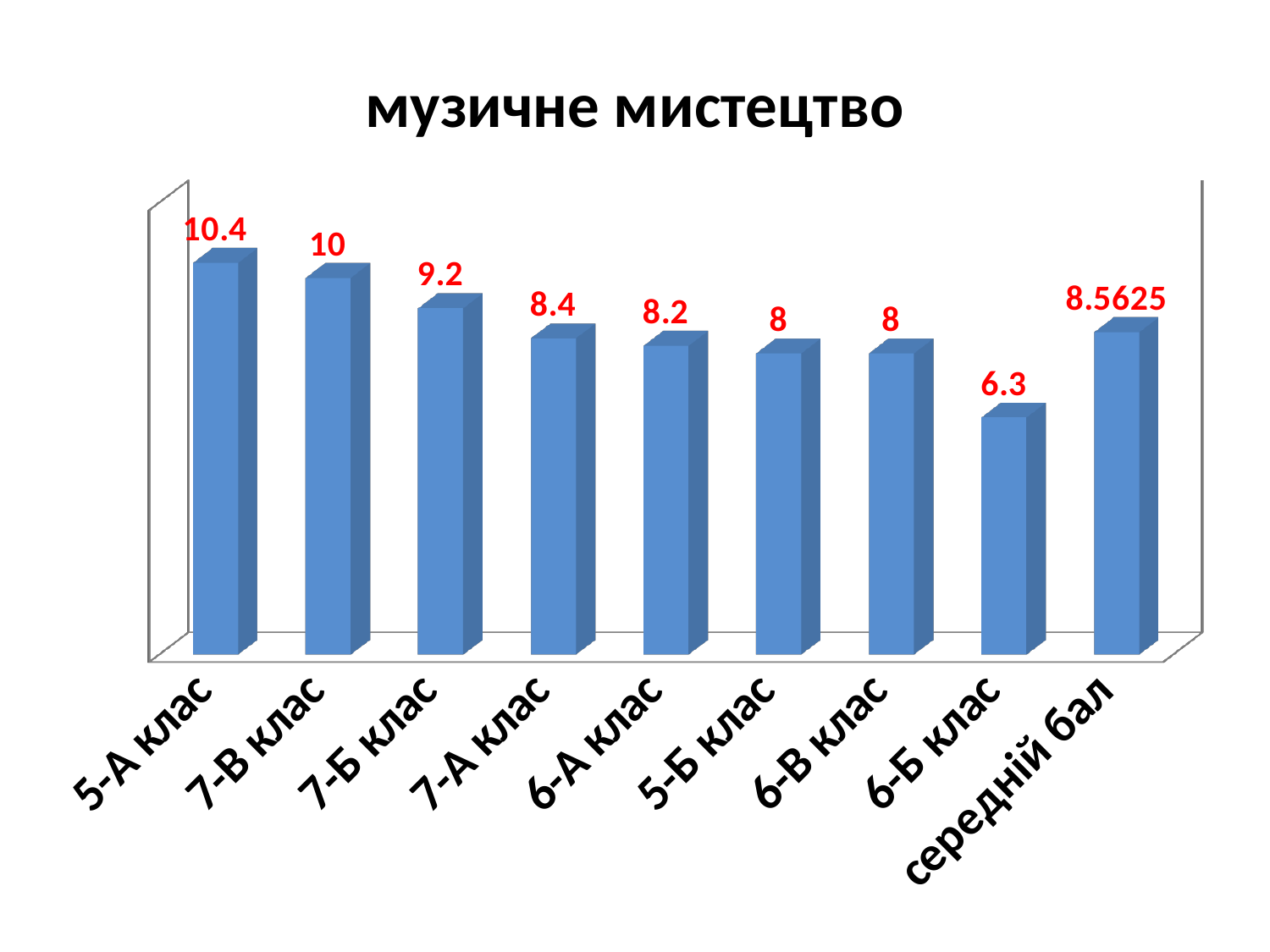
Which category has the highest value? 5-А клас What is the value for середній бал? 8.5625 What is the value for 6-Б клас? 6.3 What is the value for 7-Б клас? 9.2 What is the value for 5-А клас? 10.4 What is the title of the chart? музичне мистецтво How many categories are shown on the x axis? 9 What kind of chart is this? bar chart What is the difference between the values for 5-А клас and 7-В клас? 0.4 Which is larger, the value for 7-Б клас or the value for 6-А клас? 7-Б клас Which category has the lowest value? 6-Б клас What is the difference between the values for 7-А клас and 6-Б клас? 2.1